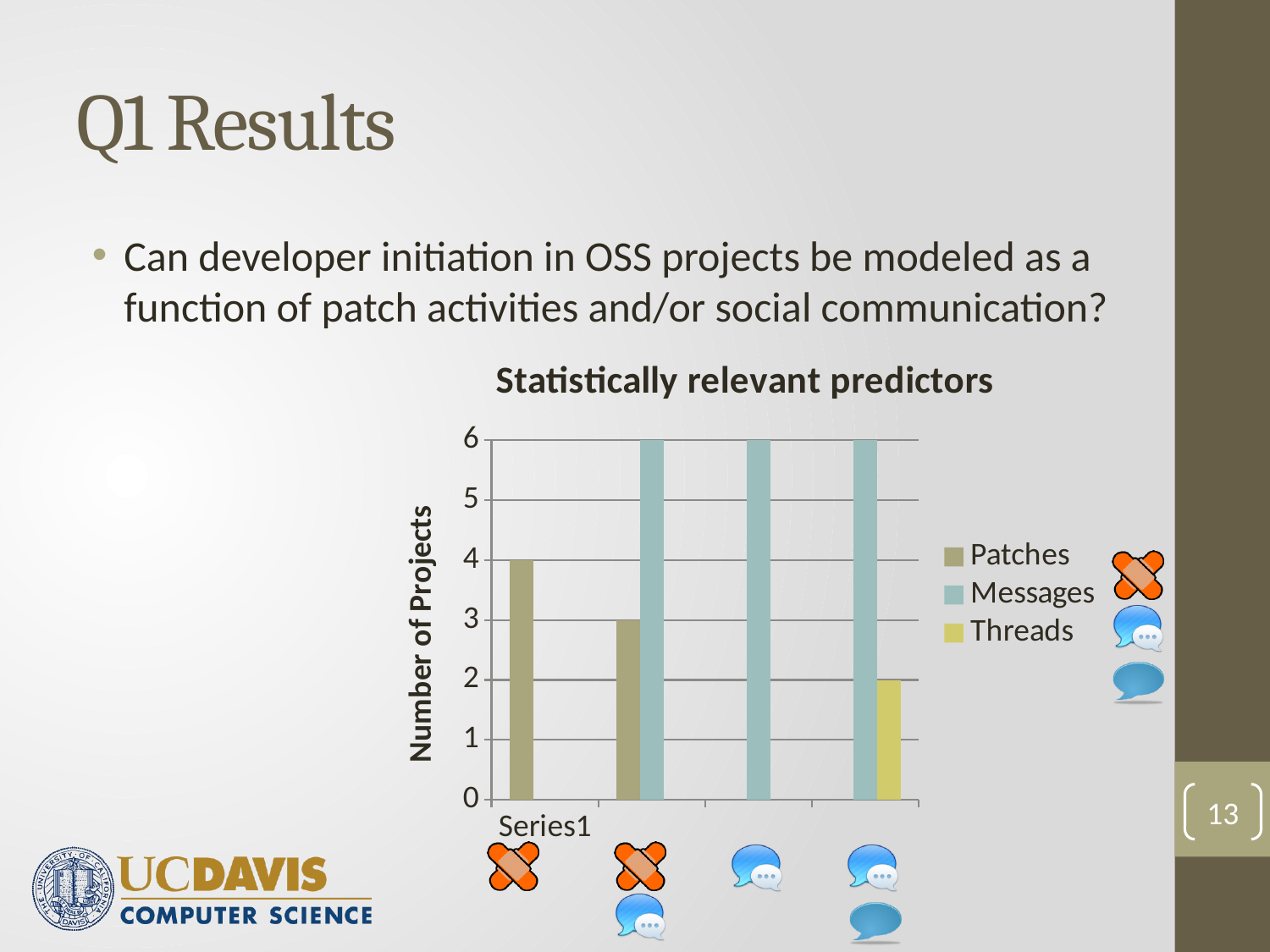
What is the value of the Patches bar for the category labeled Series1? 4 What kind of chart is shown under the title 'Statistically relevant predictors'? bar chart In the second group from the left, what is the difference between the Messages bar and the Patches bar? 3 What is the value of the Patches bar in the second group from the left? 3 What is the title of the vertical axis in the 'Statistically relevant predictors' chart? Number of Projects How many category groups of bars are plotted along the x axis of the chart? 4 Is the Patches value for Series1 greater or less than 5? less What is the value of the Messages bar in the second group from the left? 6 Which series are listed in the legend of the chart? Patches, Messages, Threads How many series does the legend of the 'Statistically relevant predictors' chart list? 3 In the second group from the left, which is larger, the Patches bar or the Messages bar? Messages What is the value of the Threads bar in the rightmost group? 2